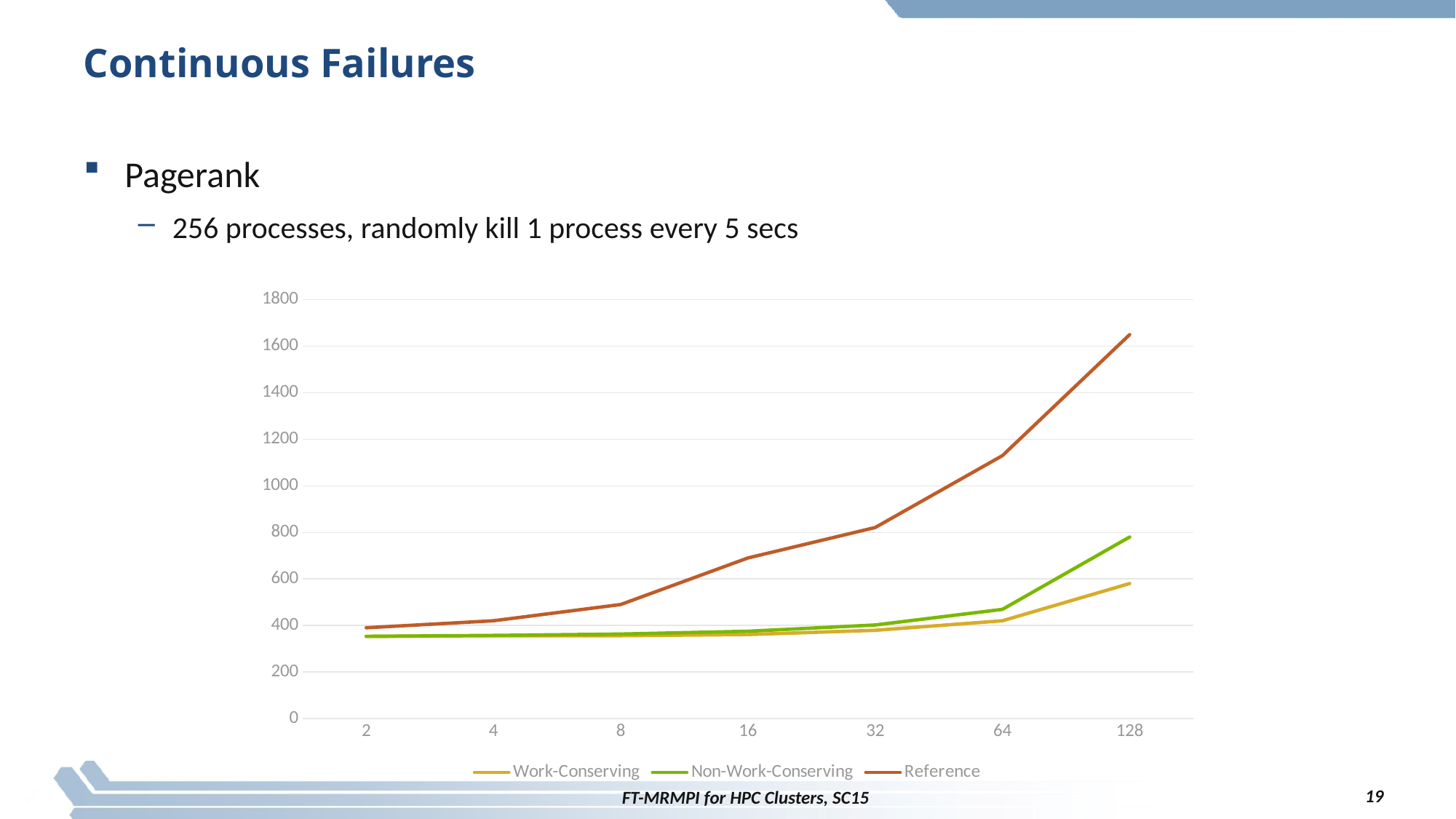
Is the value for Reference at x = 128 greater or less than 1600? greater What is the name of the series drawn in orange? Reference At x = 64, which is larger: Non-Work-Conserving or Work-Conserving? Non-Work-Conserving Is the value for Reference at x = 64 greater or less than 1000? greater How many points are on the x axis of the chart? 7 Which series has the lowest value at x = 128? Work-Conserving What kind of chart is shown on the slide? line chart How many series does the legend list? 3 Do the values for the Reference series rise or fall as x increases from 2 to 128? rise Which series has the highest value at x = 128? Reference Is the value for Non-Work-Conserving at x = 128 greater or less than 600? greater